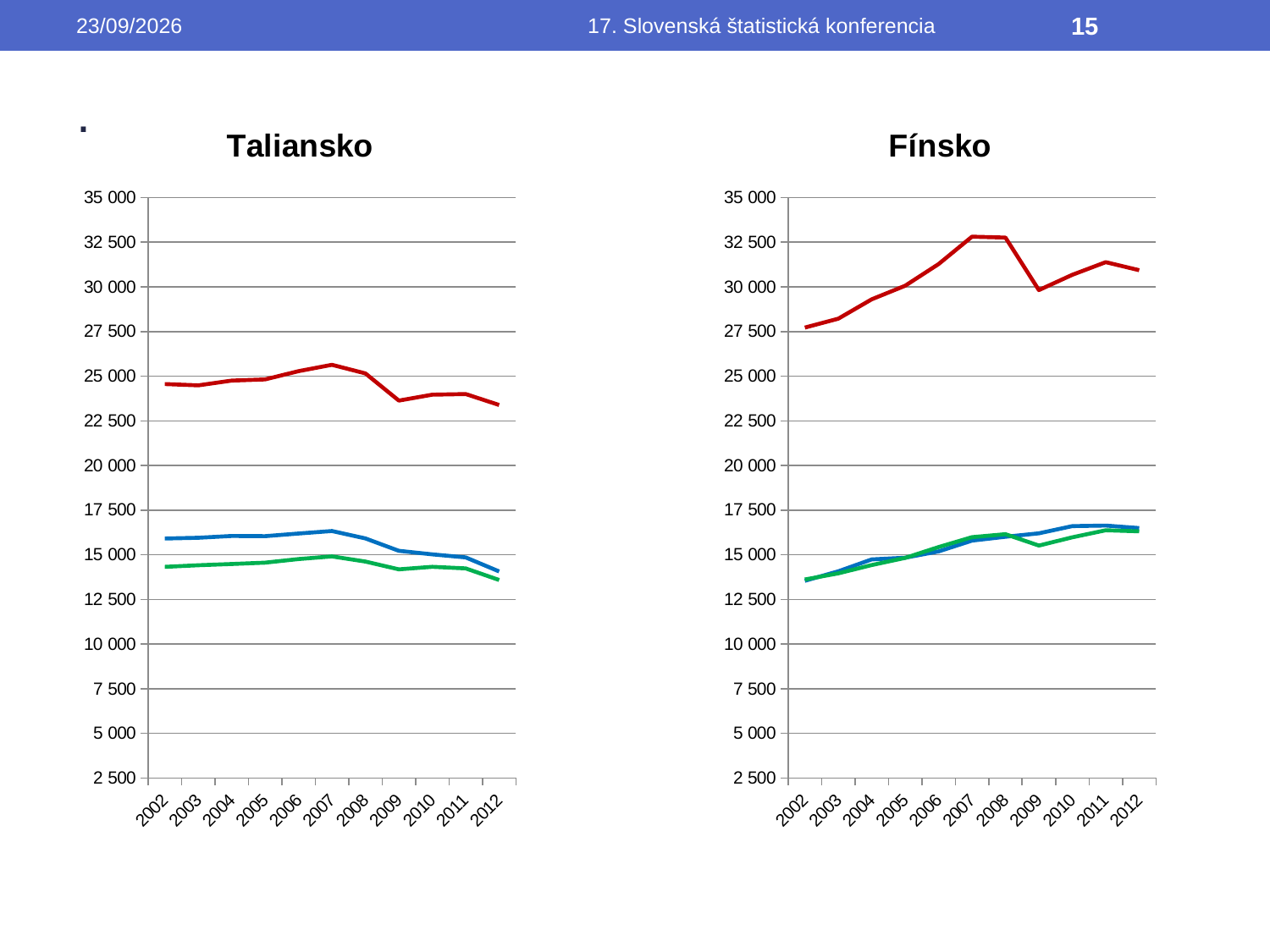
What kind of chart is the Taliansko chart? line chart In the Taliansko chart, is the value of the green line in 2012 greater or less than 15 000? less In the Taliansko chart, does the red line overall rise or fall from 2002 to 2012? fall In the Fínsko chart, is the value of the green line in 2002 greater or less than 15 000? less In the Taliansko chart, is the value of the red line in 2007 greater or less than 25 000? greater In the Fínsko chart, is the red line higher in 2008 or in 2009? 2008 In the Taliansko chart, in which year does the red line reach its highest value? 2007 In the Fínsko chart, in which year does the red line have its lowest value? 2002 How many years are shown on the x axis of the Fínsko chart? 11